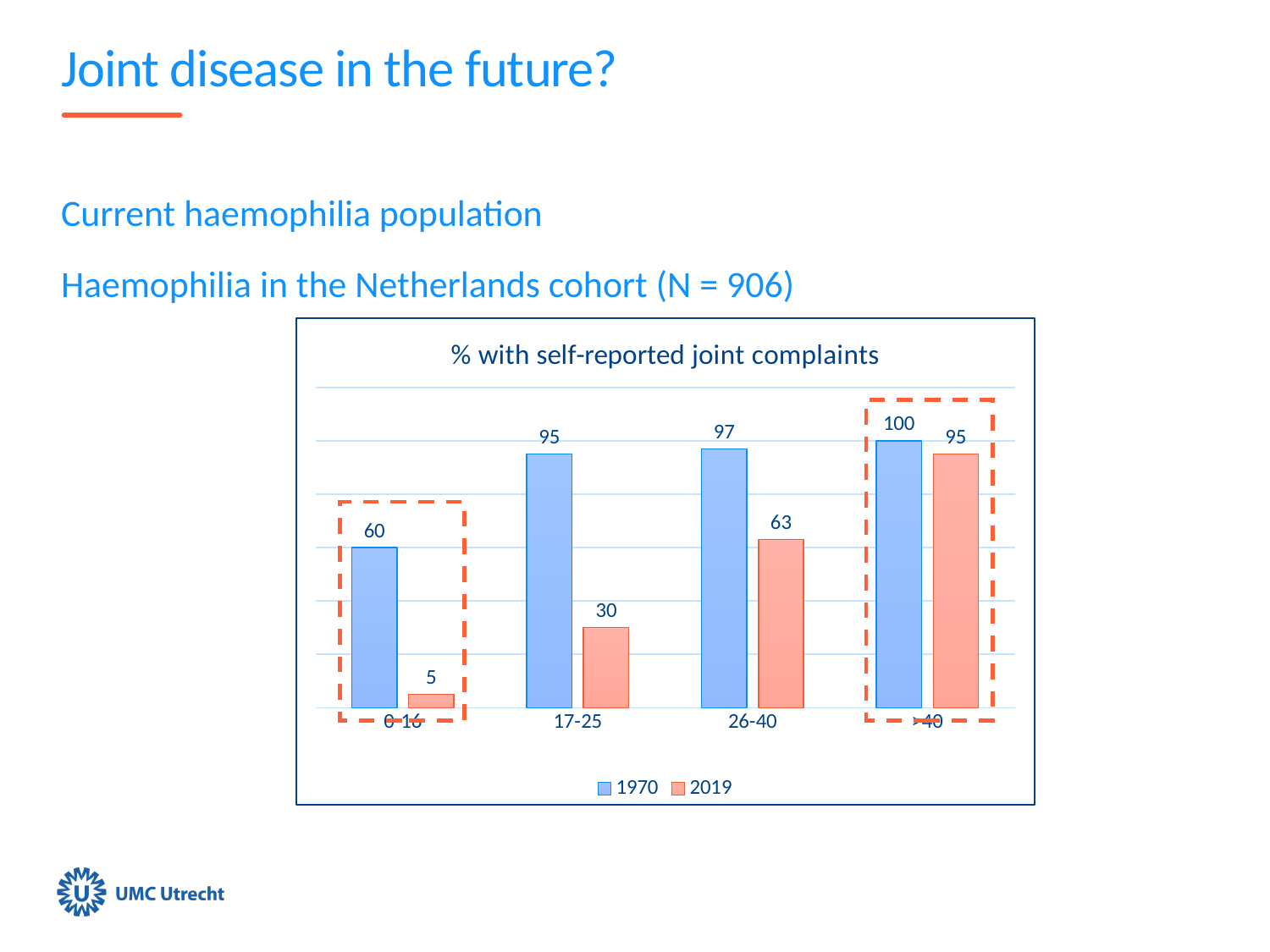
Do the values for the 2019 series rise or fall from the 0-16 group to the >40 group? rise What type of chart is shown on the slide? bar chart What is the chart's title? % with self-reported joint complaints How many age-group categories are shown on the x axis? 4 What is the value for the 2019 series in the 0-16 age group? 5 What is the difference between the 1970 and 2019 values in the 26-40 age group? 34 How many series does the legend list? 2 What is the value for the 1970 series in the 26-40 age group? 97 What is the value for the 2019 series in the 17-25 age group? 30 Which age group has the highest value for the 1970 series? >40 Which age group has the lowest value for the 2019 series? 0-16 Which is larger in the 17-25 age group: the 1970 value or the 2019 value? 1970